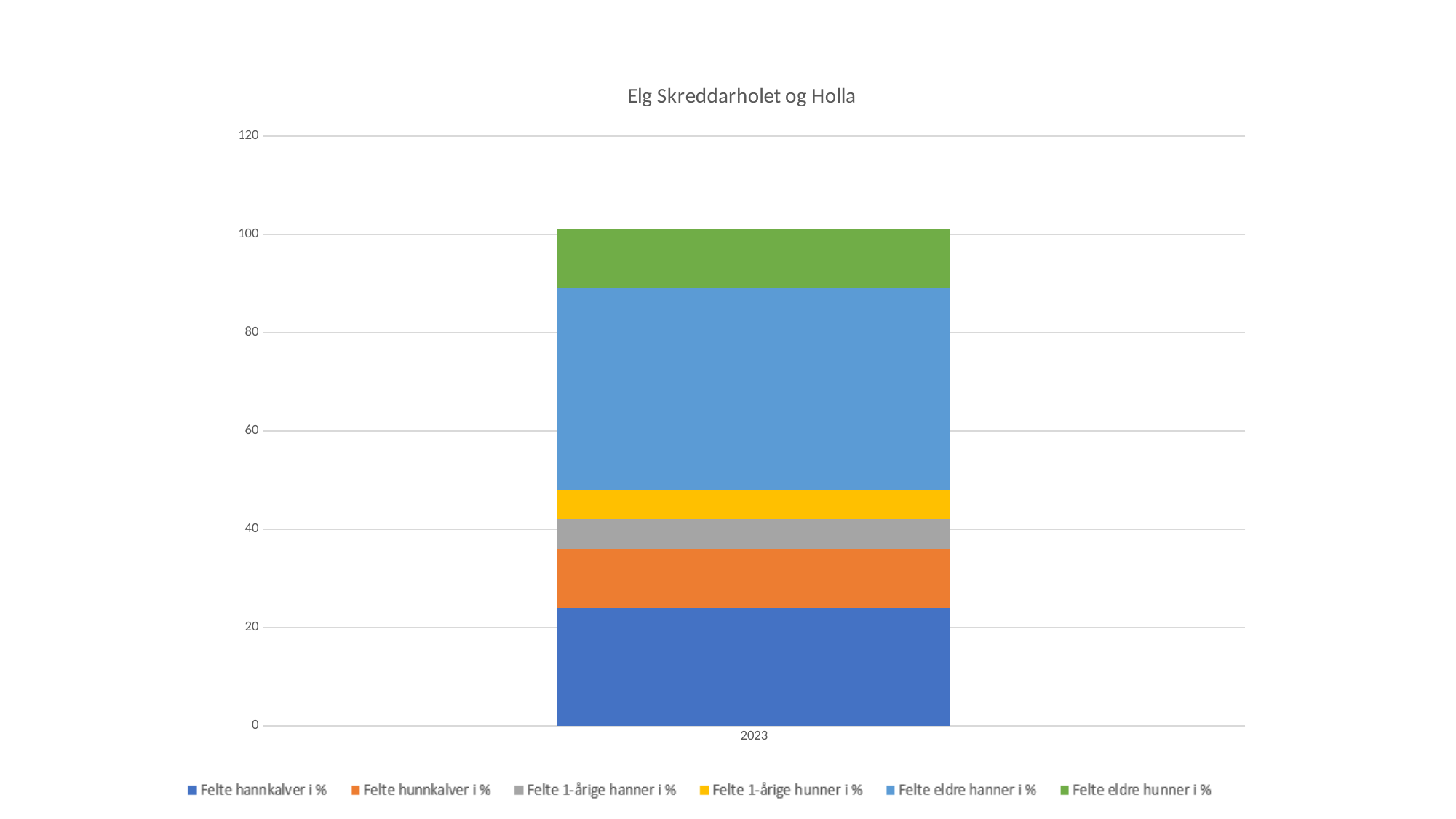
Is the total height of the 2023 stacked bar greater or less than 80? greater Is the value for Felte hannkalver i % in 2023 greater or less than 20? greater Which series has the largest segment in the 2023 bar? Felte eldre hanner i % Which is larger in 2023, Felte hannkalver i % or Felte hunnkalver i %? Felte hannkalver i % How many series does the legend list? 6 What is the title of the chart? Elg Skreddarholet og Holla Which is larger in 2023, Felte eldre hanner i % or Felte eldre hunner i %? Felte eldre hanner i % How many categories are shown on the x axis? 1 What kind of chart is shown on the slide? Stacked bar chart Is the value for Felte eldre hanner i % in 2023 greater or less than 20? greater Which year is shown on the x axis? 2023